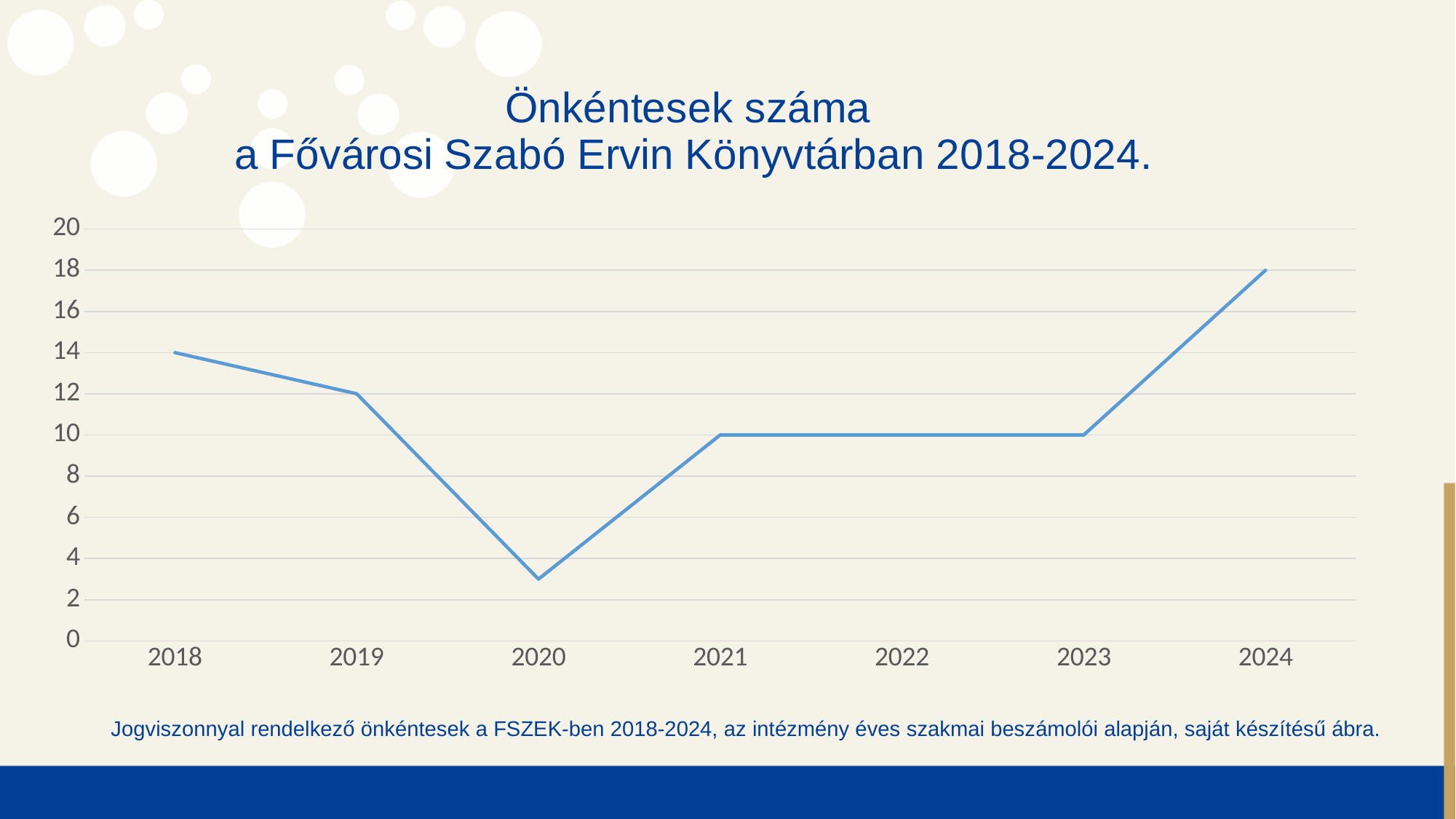
What kind of chart is shown on the slide? line chart What is the value for 2019? 12 What is the value for 2018? 14 What is the value for 2024? 18 Which year has the highest value? 2024 Is the value for 2020 greater or less than 4? less Do the values rise, fall or stay the same from 2021 to 2023? stay the same What is the value for 2022? 10 Which is larger, the value for 2019 or the value for 2023? 2019 How many years are plotted on the x axis? 7 What is the difference between the values for 2024 and 2018? 4 Which year has the lowest value? 2020